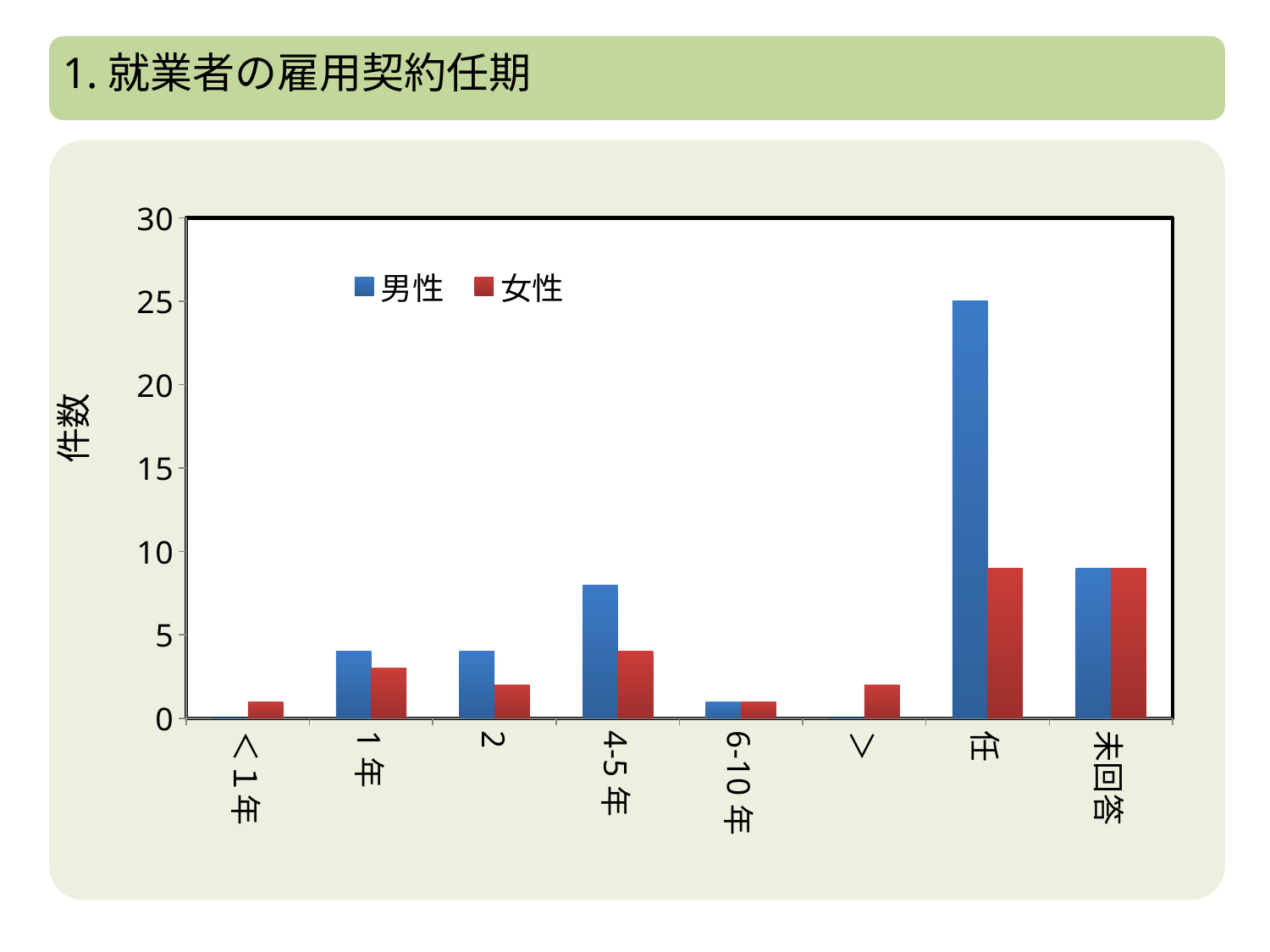
How many series does the legend list? 2 How many categories are shown on the x axis? 8 What is the label on the y axis? 件数 Is the value for 女性 in the 任 category greater or less than 10? less Is the value for 男性 in the 4-5 年 category greater or less than 5? greater In the ＜1 年 category, which is larger, 男性 or 女性? 女性 In the 任 category, which is larger, 男性 or 女性? 男性 Is the value for 男性 in the 任 category greater or less than 20? greater Which category has the highest value for 男性? 任 What is the value for 男性 in the 任 category? 25 What kind of chart is shown on the slide? bar chart